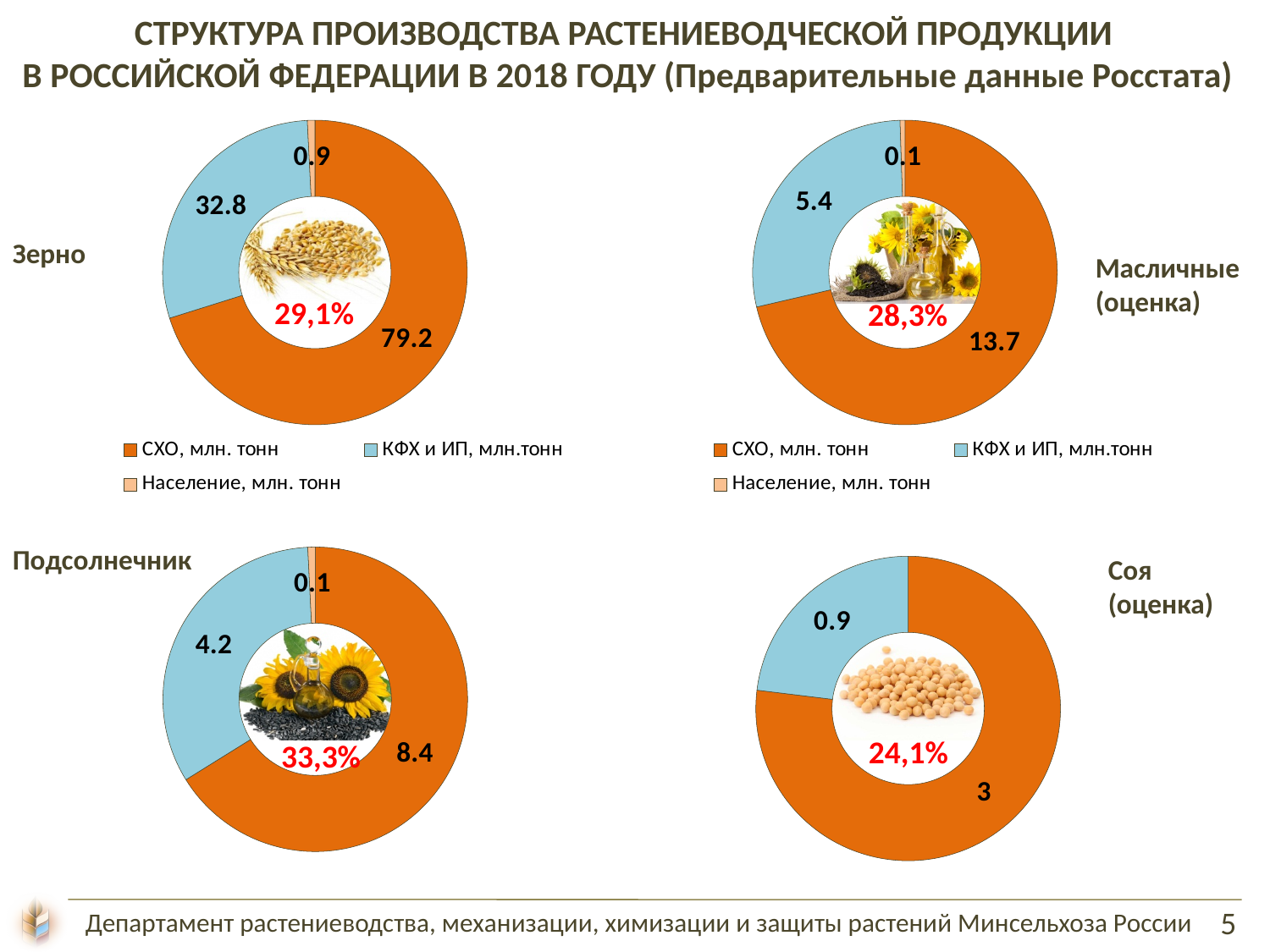
In the Зерно chart, which category has the largest value? СХО, млн. тонн In the Зерно chart, what is the difference between the СХО value and the КФХ и ИП value? 46.4 How many series does the legend of the Масличные (оценка) chart list? 3 In the Подсолнечник chart, which category has the smallest value? Население, млн. тонн What kind of chart is used for Зерно? Doughnut (pie) chart In the Подсолнечник chart, what is the value for the КФХ и ИП segment? 4.2 In the Зерно chart, what is the value for КФХ и ИП, млн.тонн? 32.8 In the Масличные (оценка) chart, what is the value for КФХ и ИП, млн.тонн? 5.4 In the Зерно chart, what is the value for СХО, млн. тонн? 79.2 In the Зерно chart, what is the value for Население, млн. тонн? 0.9 In the Соя (оценка) chart, what is the value for the СХО segment? 3 In the Масличные (оценка) chart, what is the value for СХО, млн. тонн? 13.7